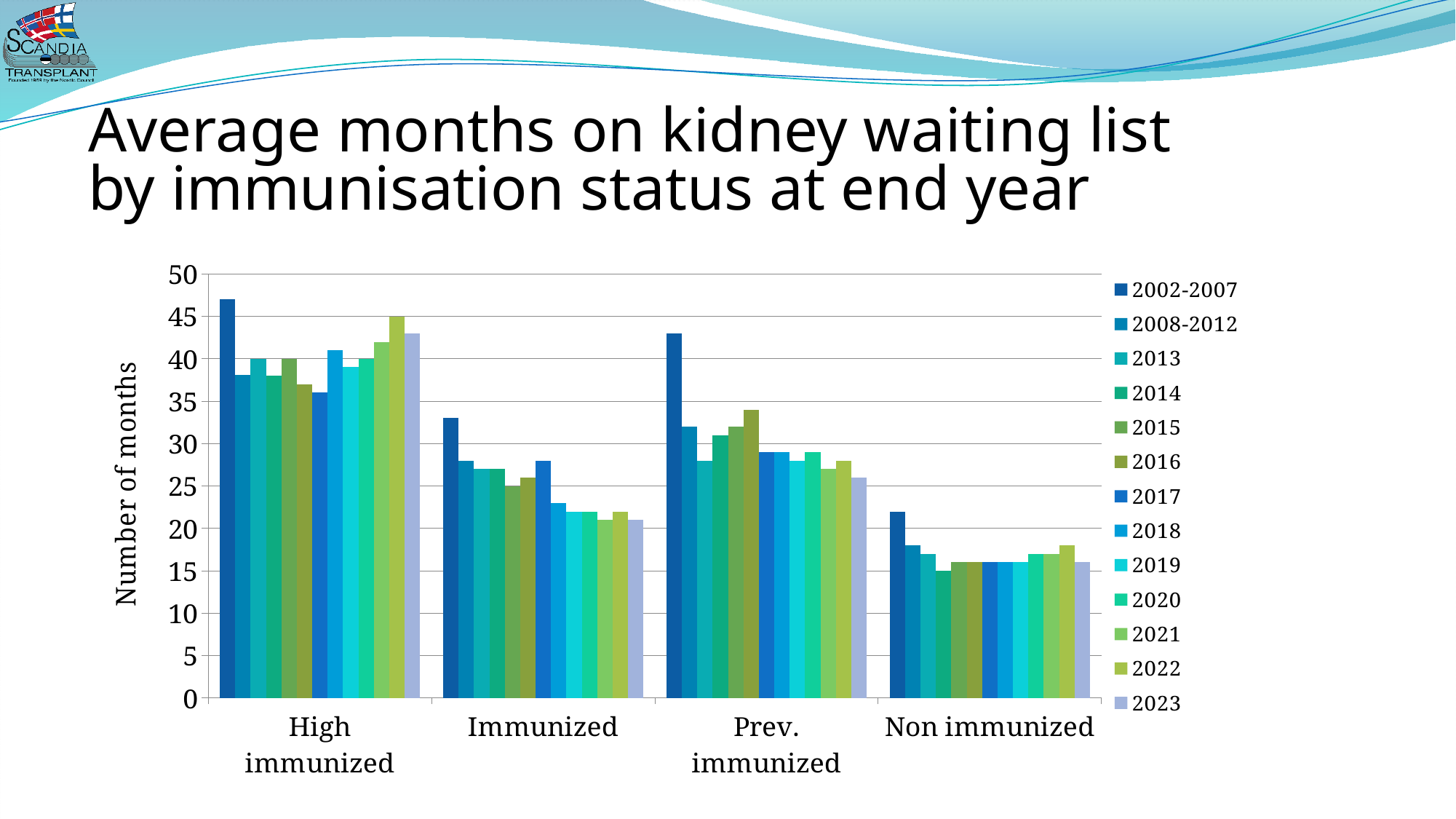
How many immunisation status categories are shown on the x axis? 4 Which category has the lowest value for the 2023 series? Non immunized What kind of chart is shown on the slide? bar chart For the 2022 series, which is larger: High immunized or Immunized? High immunized Is the value for 2002-2007 in the Non immunized category greater or less than 20? greater In the Prev. immunized category, which is larger: 2002-2007 or 2008-2012? 2002-2007 Is the value for 2002-2007 in the High immunized category greater or less than 45? greater How many series does the legend list? 13 What is the title of the y axis? Number of months Is the value for 2023 in the Immunized category greater or less than 25? less Which category has the highest value for the 2002-2007 series? High immunized